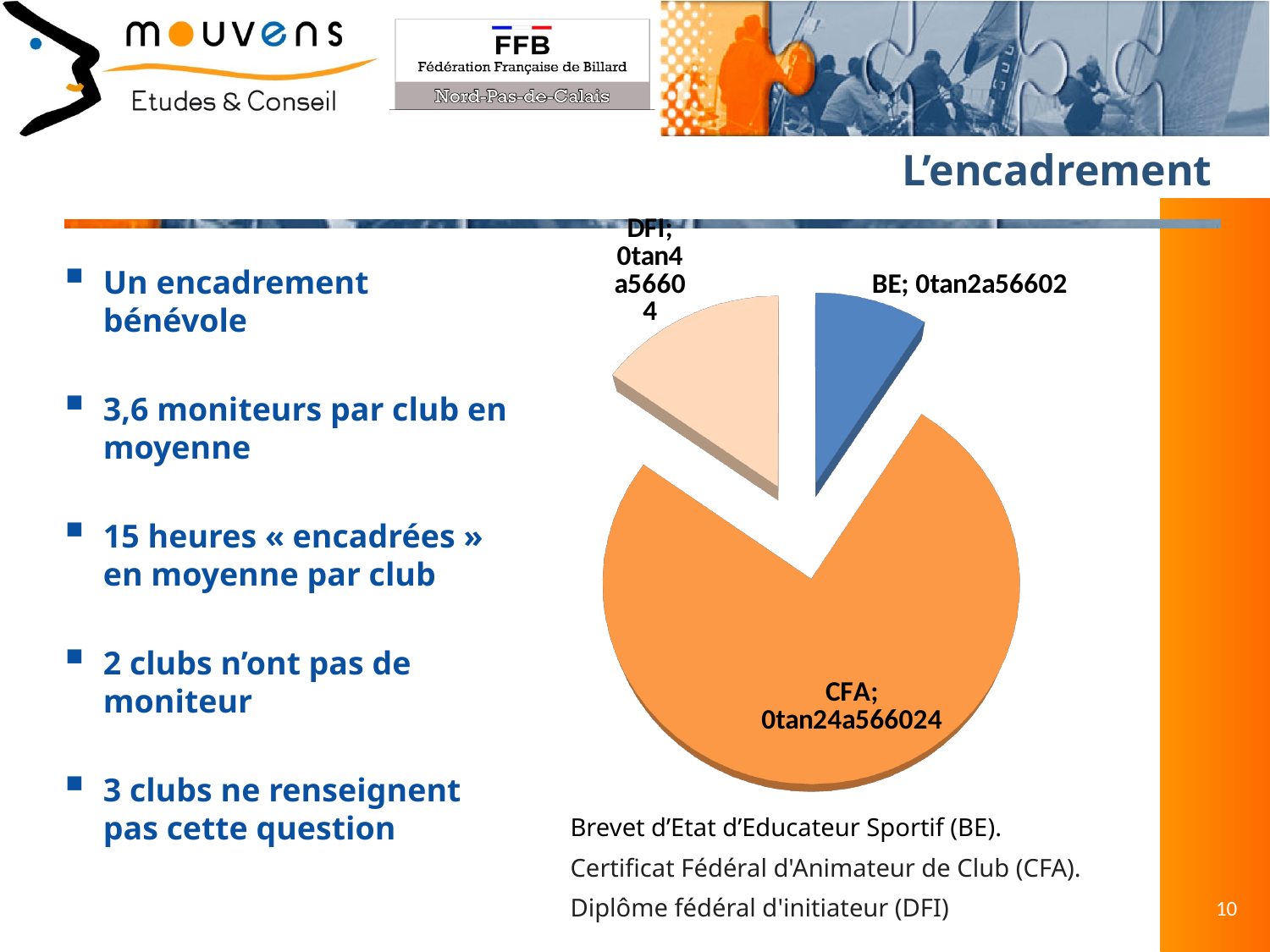
What colour is the CFA slice in the pie chart? orange Which slice is larger in the pie chart, BE or DFI? DFI Does the CFA slice take up more or less than half of the pie chart? more Which slice is larger in the pie chart, CFA or BE? CFA What kind of chart is shown on the slide? pie chart How many slices does the pie chart have? 3 Which slice is larger in the pie chart, CFA or DFI? CFA What colour is the BE slice in the pie chart? blue Which category has the smallest slice in the pie chart? BE Which category has the largest slice in the pie chart? CFA